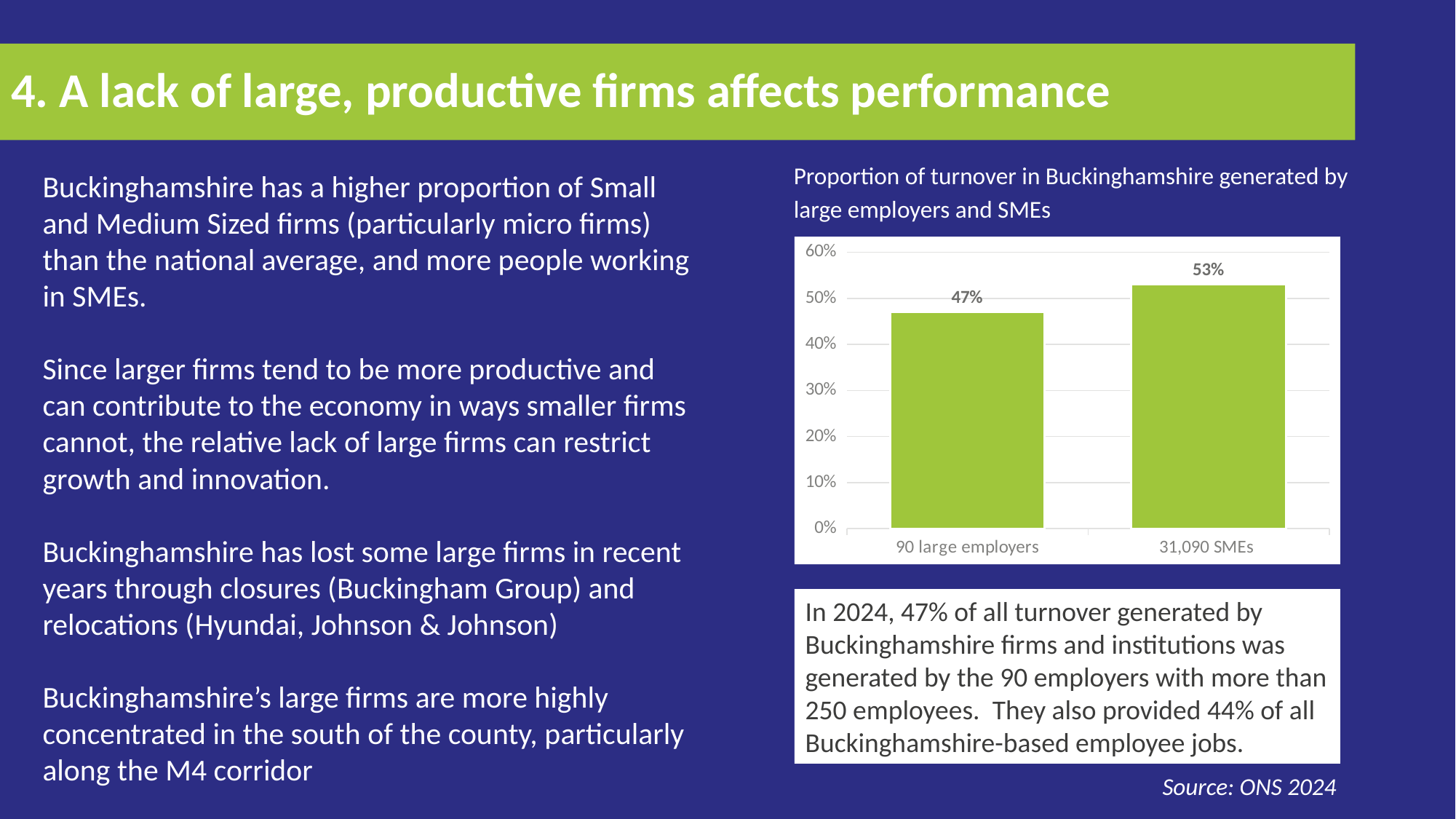
Is the value for 90 large employers greater or less than 50%? less Is the value for 31,090 SMEs greater or less than 50%? greater Which category generates the higher proportion of turnover? 31,090 SMEs How many categories are shown on the chart? 2 What is the highest value shown on the chart's vertical axis? 60% Is the turnover share of the 90 large employers larger or smaller than that of the 31,090 SMEs? smaller What is the title of the chart? Proportion of turnover in Buckinghamshire generated by large employers and SMEs What is the difference in percentage points between the turnover share of SMEs and that of large employers? 6 percentage points What type of chart is shown on the slide? Bar chart What proportion of turnover is generated by the 90 large employers? 47% Which category generates the lower proportion of turnover? 90 large employers What proportion of turnover is generated by the 31,090 SMEs? 53%